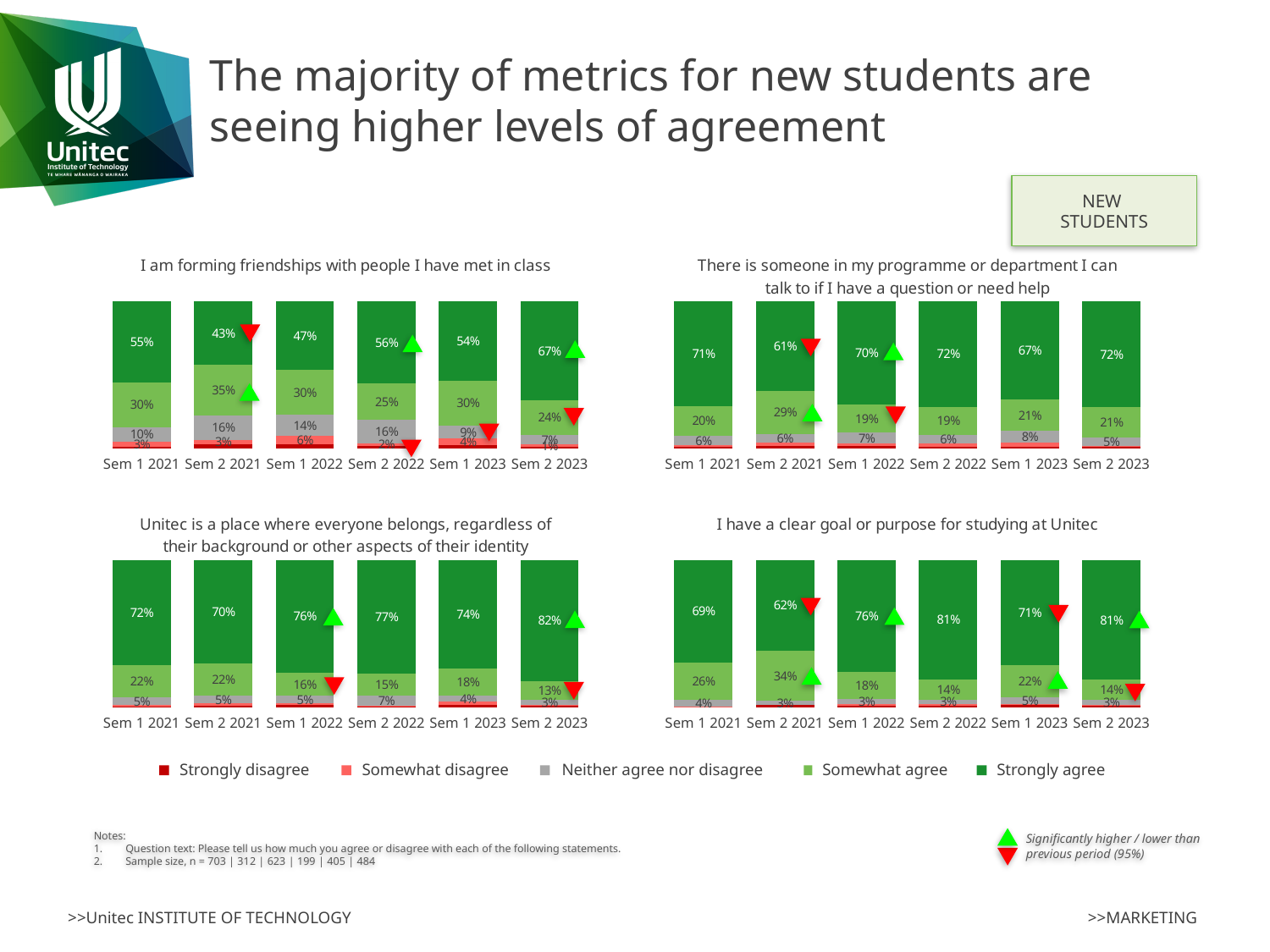
In the chart 'Unitec is a place where everyone belongs, regardless of their background or other aspects of their identity', which semester has the highest Strongly agree value? Sem 2 2023 How many series does the shared legend at the bottom of the slide list? 5 In the chart 'I am forming friendships with people I have met in class', what is the Strongly agree value for Sem 2 2023? 67% In the chart 'I have a clear goal or purpose for studying at Unitec', is the Strongly agree value larger for Sem 1 2022 or Sem 1 2023? Sem 1 2022 In the chart 'I am forming friendships with people I have met in class', which semester has the lowest Strongly agree value? Sem 2 2021 How many semesters are shown on the x axis of the chart 'I am forming friendships with people I have met in class'? 6 In the chart 'There is someone in my programme or department I can talk to if I have a question or need help', what is the difference between the Strongly agree values for Sem 1 2021 and Sem 2 2021? 10% What type of chart is 'There is someone in my programme or department I can talk to if I have a question or need help'? Stacked bar chart In the chart 'I have a clear goal or purpose for studying at Unitec', what is the difference between the Somewhat agree values for Sem 2 2021 and Sem 1 2022? 16% In the chart 'Unitec is a place where everyone belongs, regardless of their background or other aspects of their identity', what is the Somewhat agree value for Sem 1 2023? 18% In the chart 'I have a clear goal or purpose for studying at Unitec', what is the Strongly agree value for Sem 2 2022? 81% In the chart 'There is someone in my programme or department I can talk to if I have a question or need help', what is the Somewhat agree value for Sem 2 2021? 29%